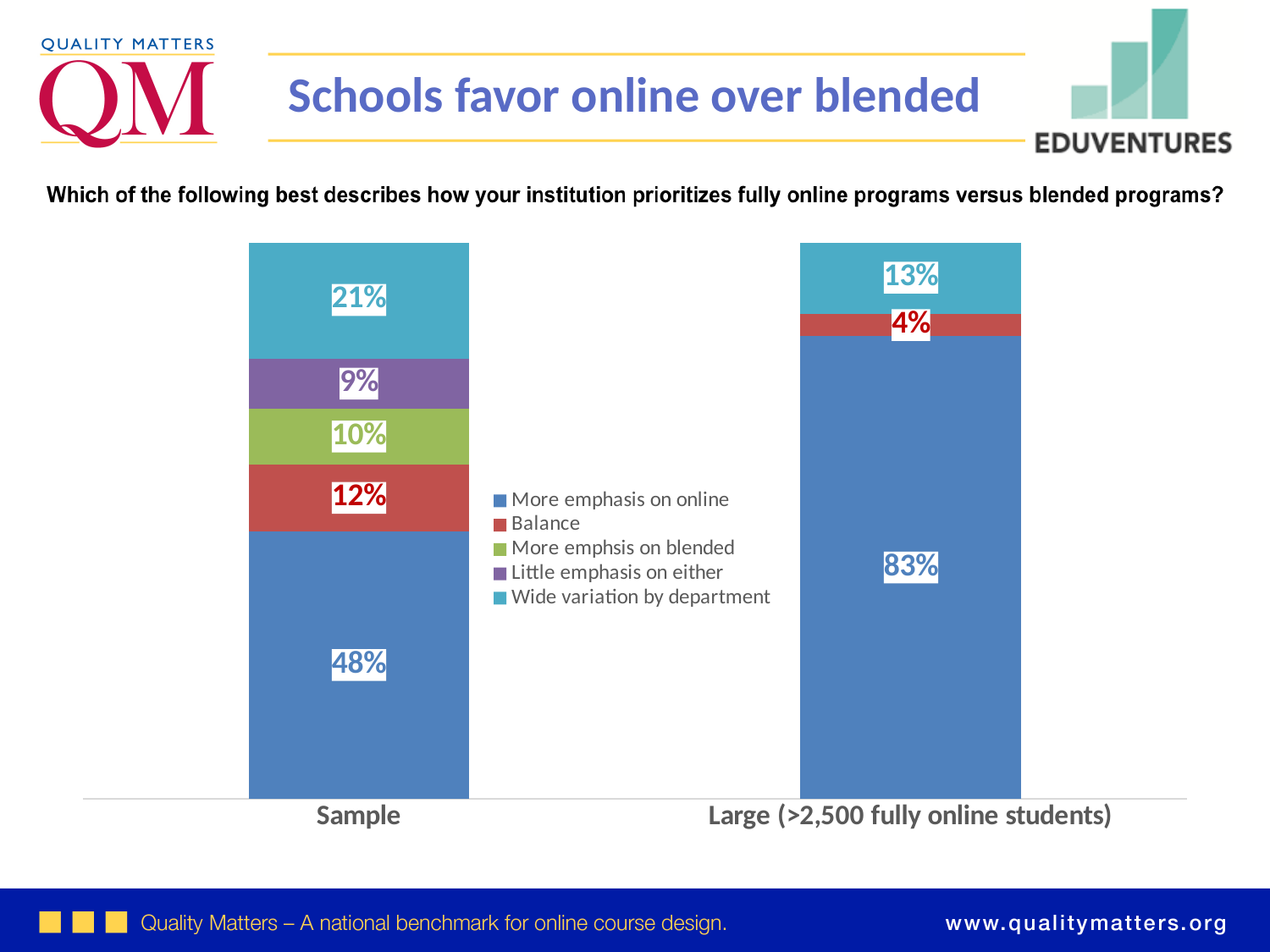
How many categories are shown on the x axis? 2 What is the difference between the "More emphasis on online" share for Large (>2,500 fully online students) and for Sample? 35% What percentage of the Large (>2,500 fully online students) category is "More emphasis on online"? 83% What kind of chart is shown on the slide? Stacked bar chart How many series does the legend list? 5 What percentage of the Sample category is "More emphasis on online"? 48% Which category has the larger "Wide variation by department" share, Sample or Large (>2,500 fully online students)? Sample Which series has the largest share in the Sample bar? More emphasis on online Which labelled series has the smallest share in the Large (>2,500 fully online students) bar? Balance What percentage of the Sample category is "Little emphasis on either"? 9% What percentage of the Sample category is "Wide variation by department"? 21% What percentage of the Large (>2,500 fully online students) category is "Balance"? 4%